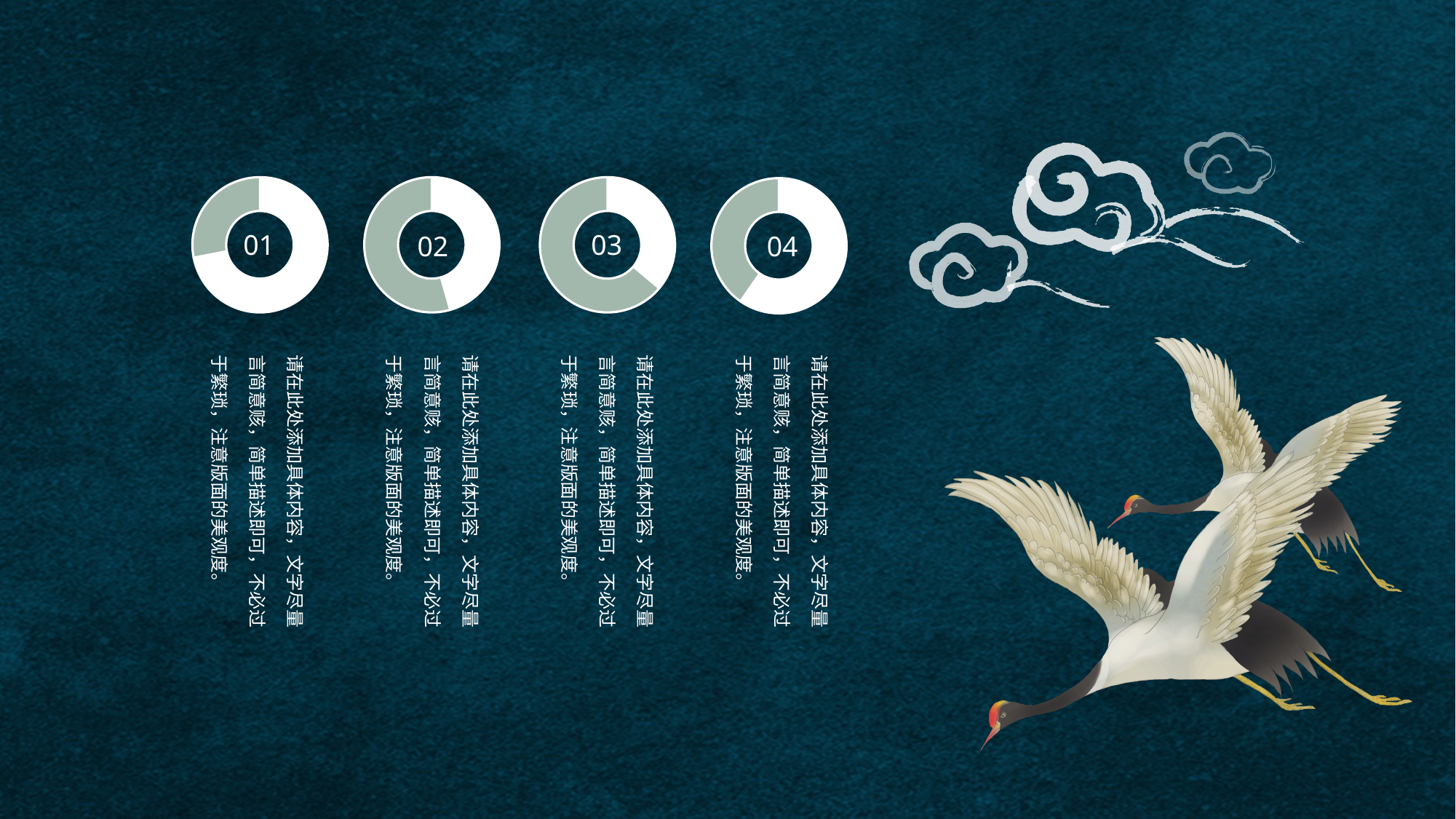
How many donut charts are shown on the slide? 4 What kind of chart is used for the four charts labelled 01 to 04 on the slide? Donut (pie) chart What two colours are used for the slices of the donut charts? Green and white Which of the four donut charts has the smallest green slice? 01 How many slices does the donut chart labelled 01 have? 2 What label is printed in the centre of the third donut chart from the left? 03 Is the green slice larger in the donut chart labelled 03 or in the one labelled 01? 03 Which of the four donut charts has the largest green slice? 03 Is the green slice larger in the donut chart labelled 02 or in the one labelled 04? 02 Is the green slice larger in the donut chart labelled 02 or in the one labelled 03? 03